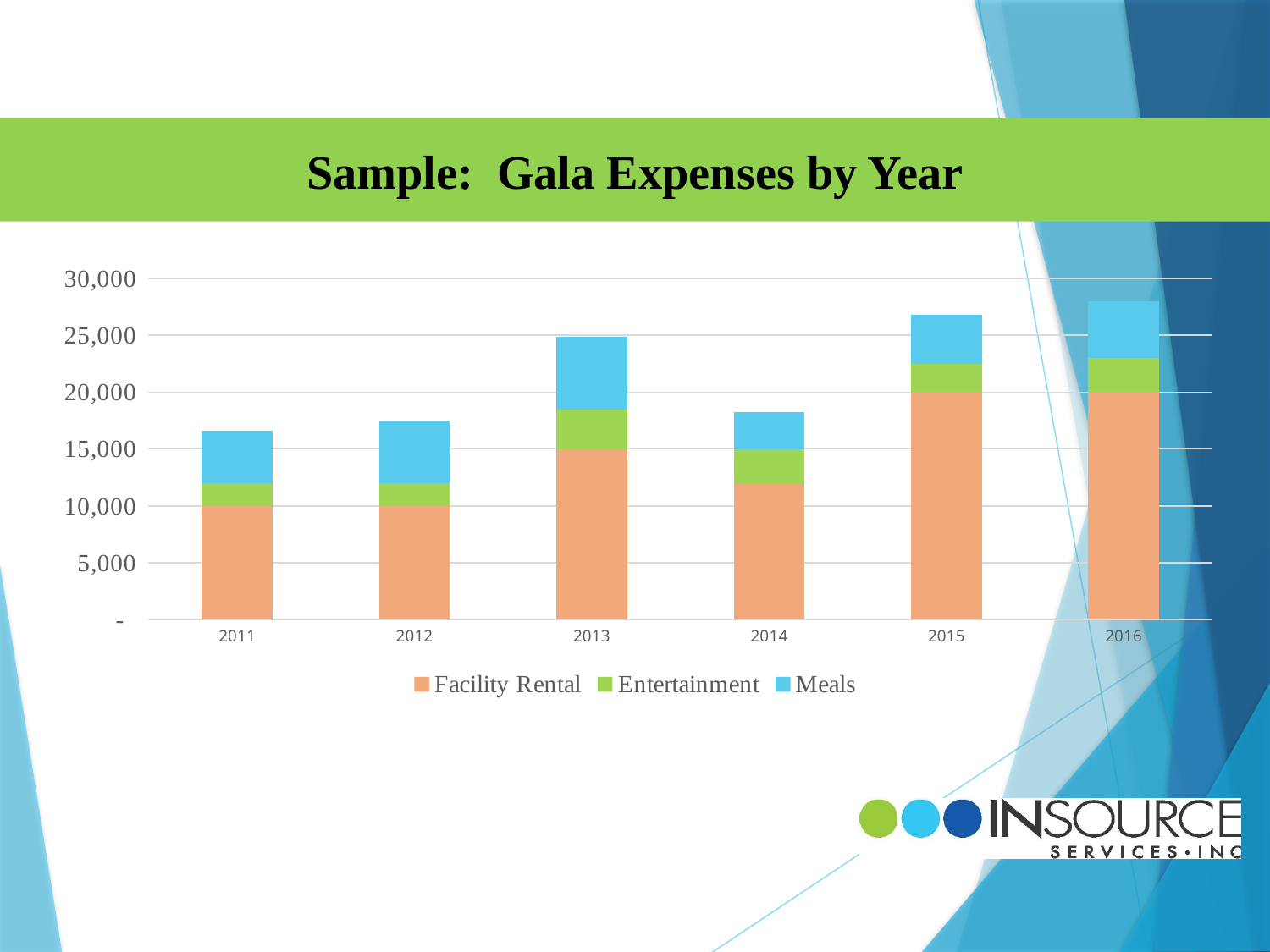
What is the Facility Rental value for 2011? 10,000 What is the title of the chart slide? Sample: Gala Expenses by Year Is the total for 2013 greater or less than 20,000? greater Which series is shown in orange in the legend? Facility Rental What is the Facility Rental value for 2015? 20,000 How many years are shown on the x axis of the chart? 6 What kind of chart is shown on the slide? Stacked bar chart Which year has the highest total gala expenses? 2016 Which year has the lowest total gala expenses? 2011 Is the total for 2014 greater or less than 20,000? less How many series does the legend list? 3 Which year has the larger total expenses, 2014 or 2015? 2015